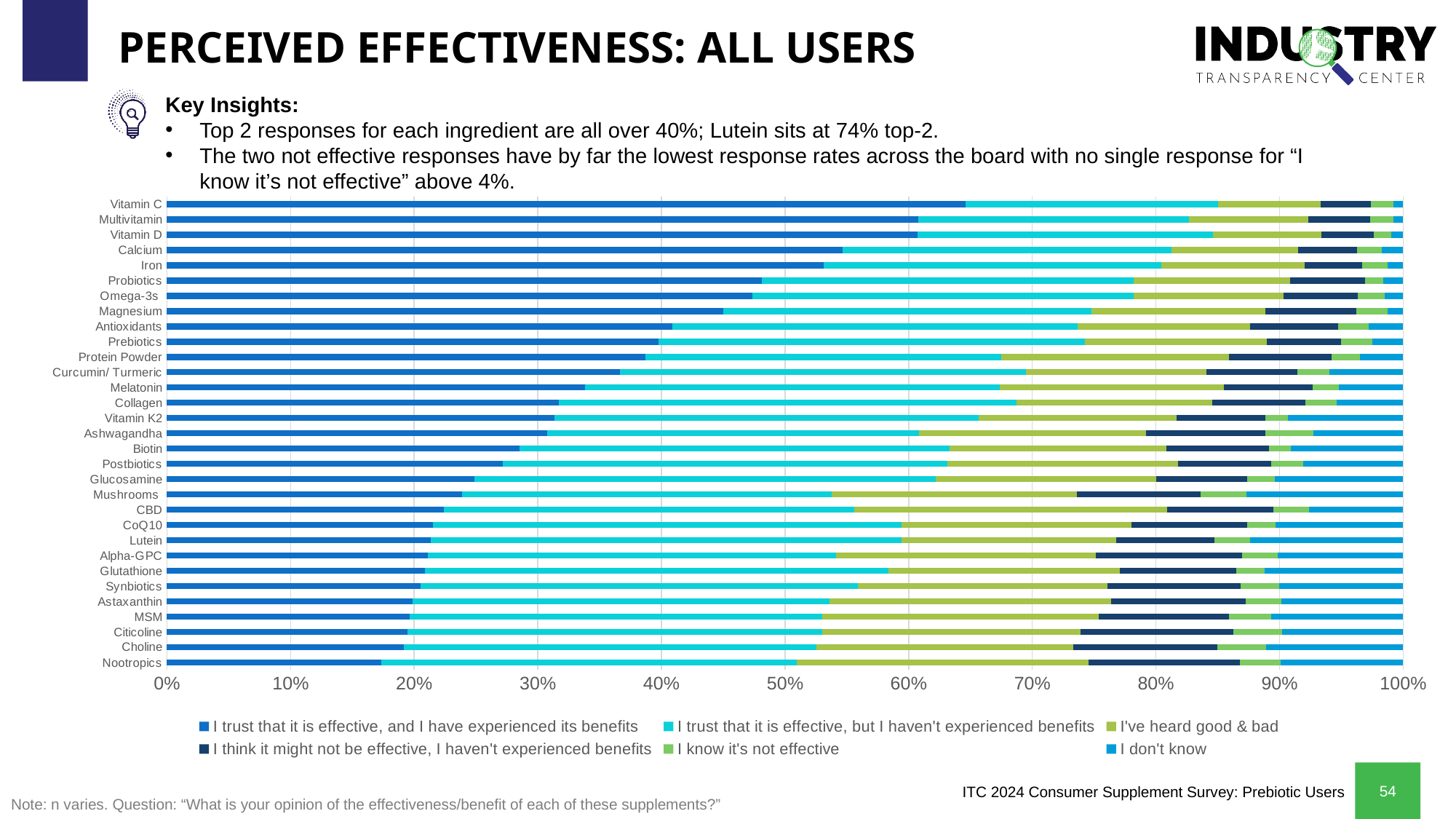
Is the "I trust that it is effective, and I have experienced its benefits" share for Nootropics greater or less than 20%? less Is the "I trust that it is effective, and I have experienced its benefits" share for Magnesium greater or less than 50%? less How many ingredients (categories) are plotted on the chart? 31 Which ingredient has the smallest share for "I trust that it is effective, and I have experienced its benefits"? Nootropics How many series does the legend list? 6 What kind of chart is shown on the slide? bar chart Which ingredient has the largest share for "I trust that it is effective, and I have experienced its benefits"? Vitamin C Which has a larger "I trust that it is effective, and I have experienced its benefits" share, Probiotics or Glucosamine? Probiotics Moving down the list from Vitamin C to Nootropics, does the "I trust that it is effective, and I have experienced its benefits" share rise or fall? fall What is the title of the slide's chart section? PERCEIVED EFFECTIVENESS: ALL USERS Is the "I trust that it is effective, and I have experienced its benefits" share for Calcium greater or less than 50%? greater